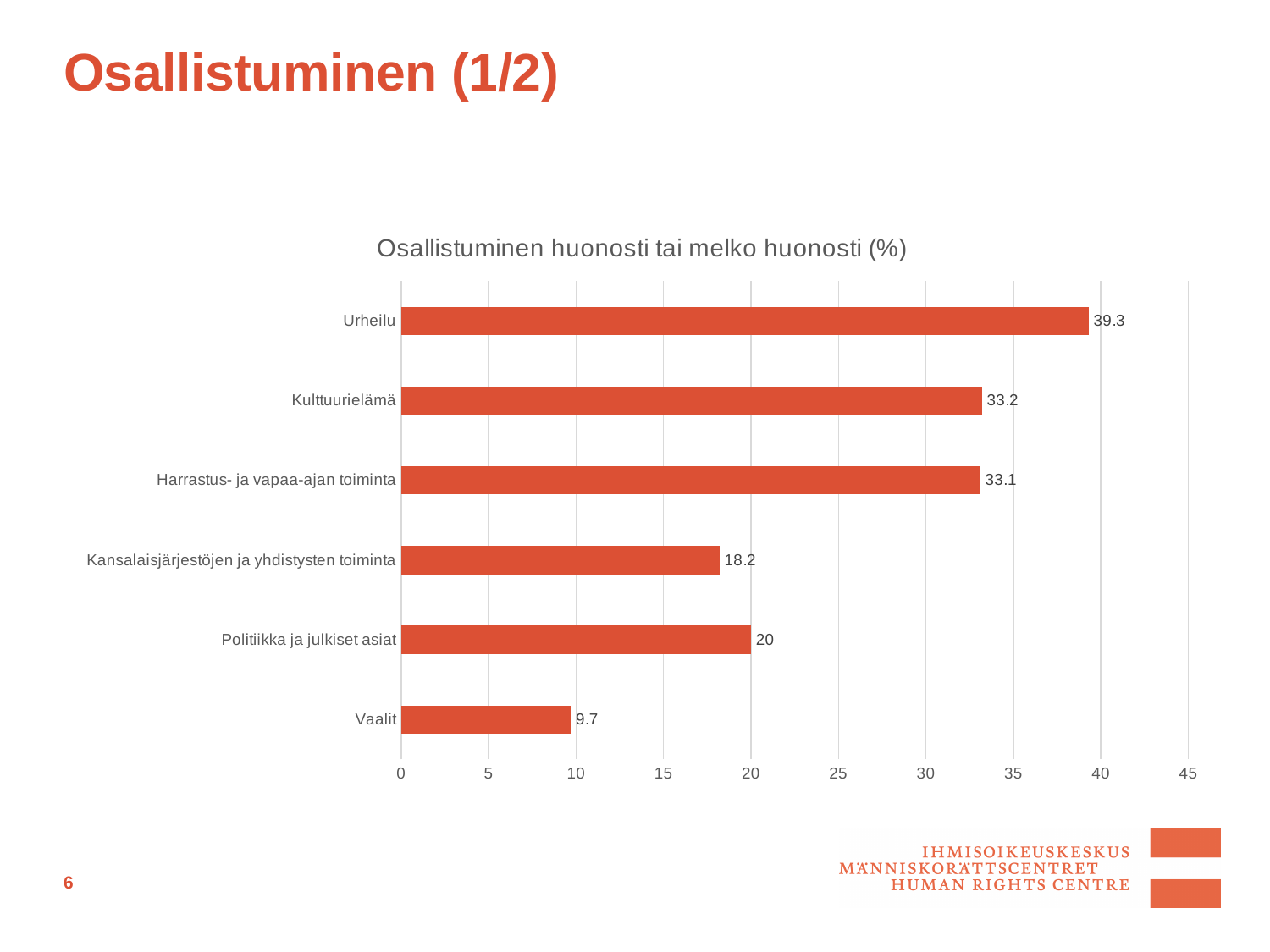
Which category has the lowest value? Vaalit What is the title of the chart? Osallistuminen huonosti tai melko huonosti (%) What is the value for Vaalit? 9.7 Which is larger, the value for Kulttuurielämä or the value for Kansalaisjärjestöjen ja yhdistysten toiminta? Kulttuurielämä Which category has the highest value? Urheilu What is the value for Urheilu? 39.3 What is the value for Kansalaisjärjestöjen ja yhdistysten toiminta? 18.2 What is the value for Politiikka ja julkiset asiat? 20 How many categories are shown in the chart? 6 What is the difference between the values for Urheilu and Vaalit? 29.6 What is the difference between the values for Politiikka ja julkiset asiat and Kansalaisjärjestöjen ja yhdistysten toiminta? 1.8 What kind of chart is shown on the slide? Bar chart